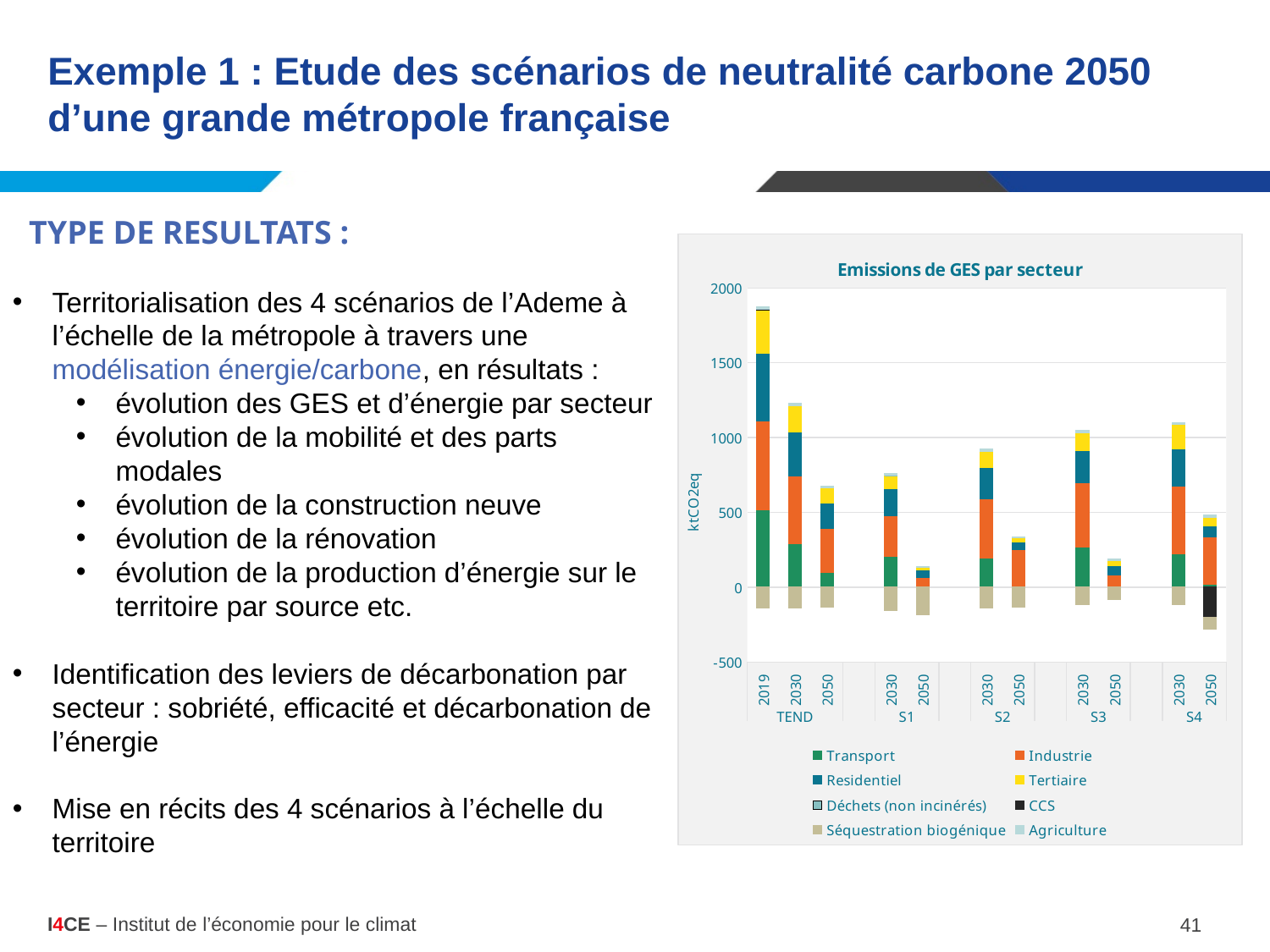
Is the total positive emissions value for S1 2050 greater or less than 500? less How many series does the legend of the chart list? 8 Is the total positive emissions value for TEND 2030 greater or less than 1000? greater Which bar has larger total positive emissions, TEND 2019 or S3 2050? TEND 2019 What is the title of the chart on the slide? Emissions de GES par secteur In the TEND scenario, do total positive emissions rise or fall from 2019 to 2050? fall How many bars are plotted in the chart? 11 Is the total positive emissions value for TEND 2019 greater or less than 1500? greater What unit is shown on the y-axis of the chart? ktCO2eq Which bar has the highest total positive emissions in the chart? TEND 2019 What type of chart is shown on the slide? Stacked bar chart